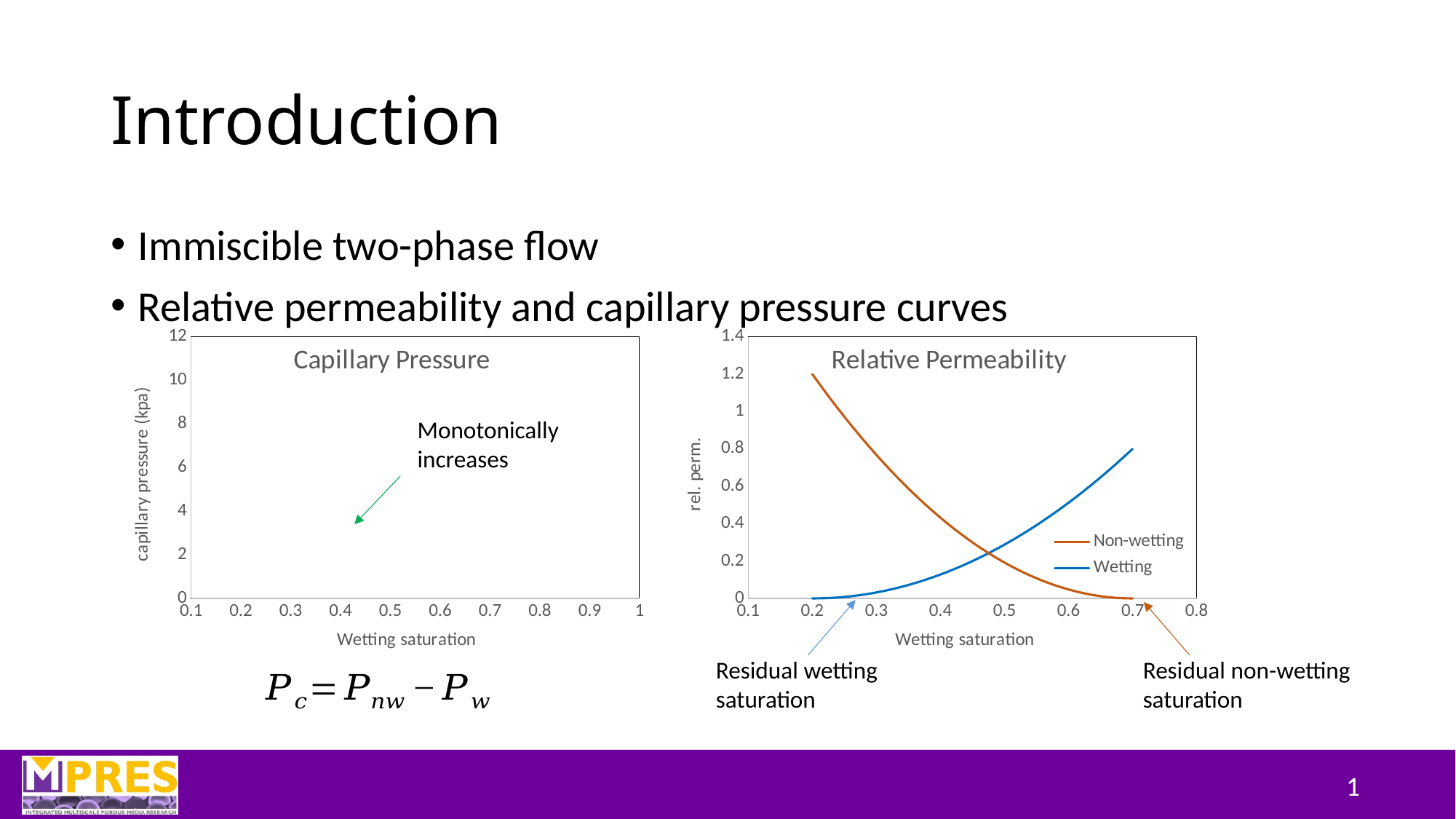
In the Relative Permeability chart, is the Wetting value at a wetting saturation of 0.7 greater or less than 1? less In the Relative Permeability chart, which series has the larger value at a wetting saturation of 0.3, Non-wetting or Wetting? Non-wetting In the Relative Permeability chart, does the Non-wetting curve rise or fall as wetting saturation increases? fall In the Relative Permeability chart, which series is drawn in blue? Wetting In the Relative Permeability chart, which series has the larger value at a wetting saturation of 0.6, Non-wetting or Wetting? Wetting In the Relative Permeability chart, is the Non-wetting value at a wetting saturation of 0.2 greater or less than 1? greater What kind of chart is the Relative Permeability chart? line chart In the Relative Permeability chart, does the Wetting curve rise or fall as wetting saturation increases? rise In the Relative Permeability chart, is the Non-wetting value at a wetting saturation of 0.7 greater or less than 0.2? less How many series does the legend of the Relative Permeability chart list? 2 What is the y-axis label of the Capillary Pressure chart? capillary pressure (kpa)